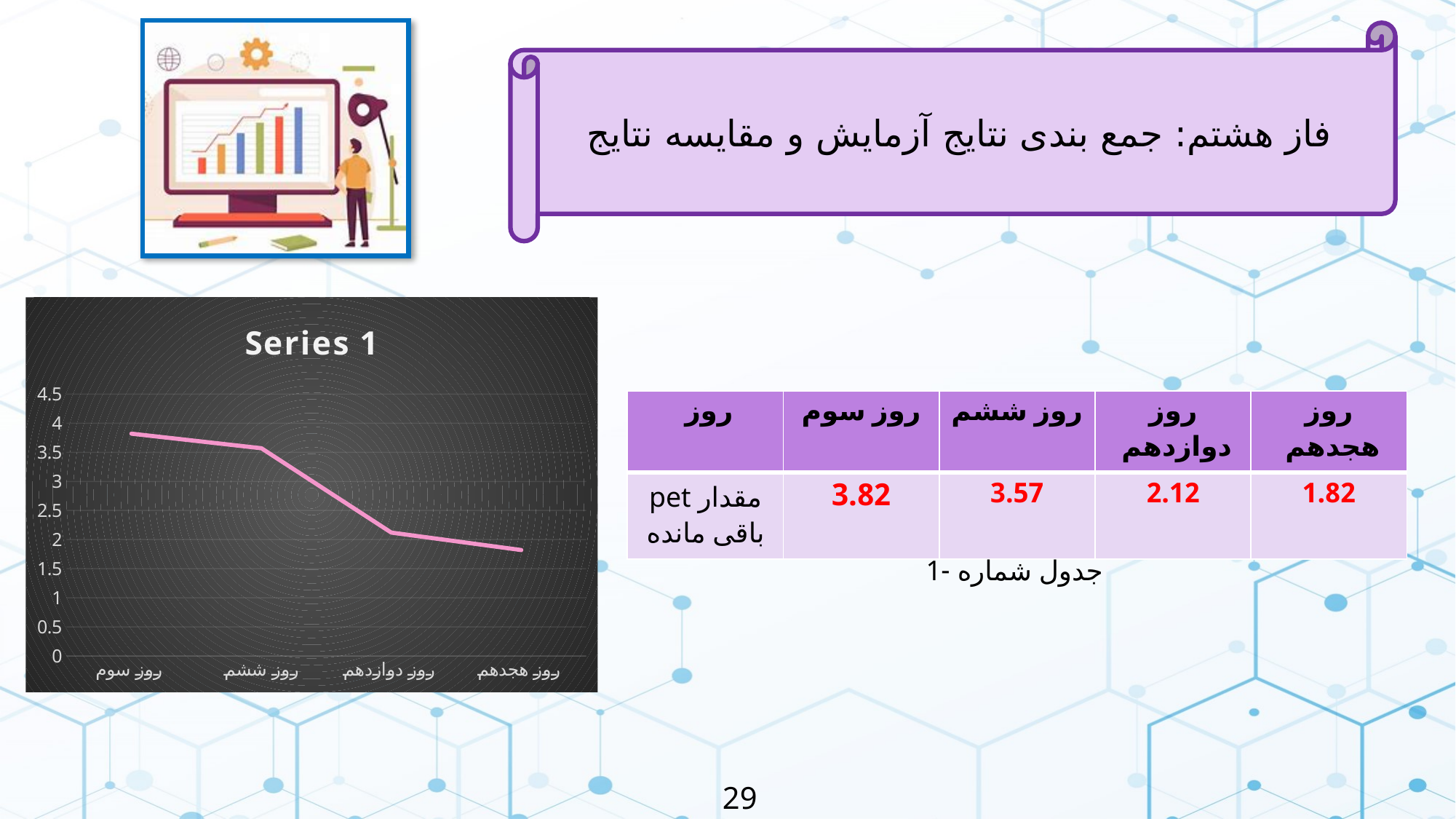
According to the table on the slide, what is the remaining pet amount for روز ششم? 3.57 Which day has the highest value in the chart? روز سوم Which day has the lowest value in the chart? روز هجدهم According to the table on the slide, what is the difference between the values for روز سوم and روز هجدهم? 2.00 Is the value for روز دوازدهم greater or less than 2.5? less How many categories (days) are plotted along the x axis of the chart? 4 Is the value for روز سوم greater or less than 3.5? greater Is the value for روز هجدهم greater or less than 2? less What is the title of the chart? Series 1 What kind of chart is shown on the slide? line chart Which is larger, the value for روز ششم or the value for روز دوازدهم? روز ششم Does the line in the chart rise or fall from روز سوم to روز هجدهم? fall